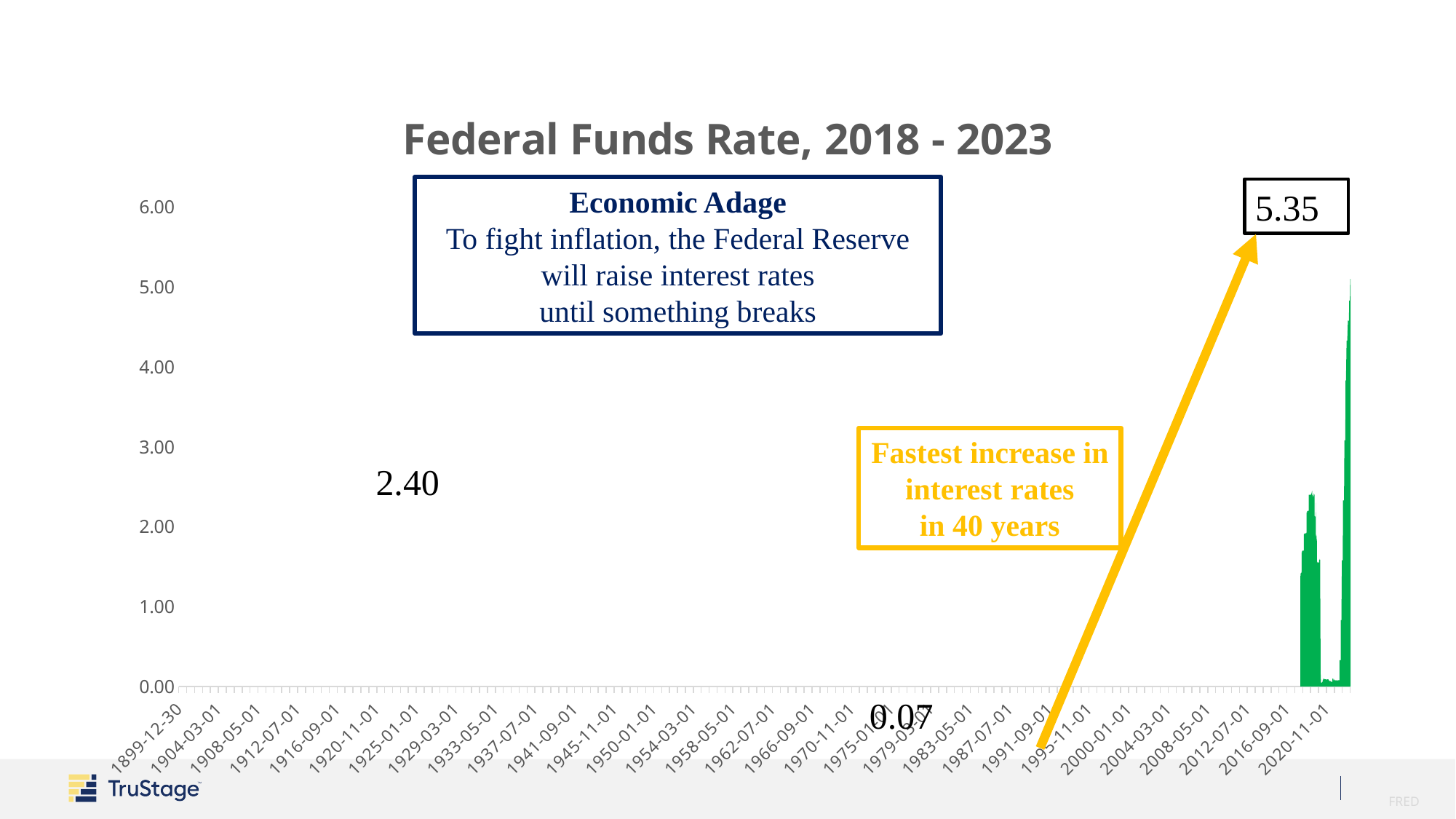
What value is labelled for the earlier, smaller peak in the federal funds rate? 2.40 What is the first date label on the x axis? 1899-12-30 What is the lowest value labelled on the chart? 0.07 Which labelled value is larger, 2.40 or 5.35? 5.35 What is the highest value labelled on the chart? 5.35 Is the final peak of the federal funds rate greater or less than 5.00? greater What is the last date label on the x axis? 2020-11-01 What is the highest value shown on the y axis? 6.00 What is the title of the chart? Federal Funds Rate, 2018 - 2023 What is the difference between the labelled peak of 5.35 and the earlier labelled peak of 2.40? 2.95 What is the difference between the labelled high of 5.35 and the labelled low of 0.07? 5.28 Does the federal funds rate rise or fall between the labelled low of 0.07 and the labelled value of 5.35? rise